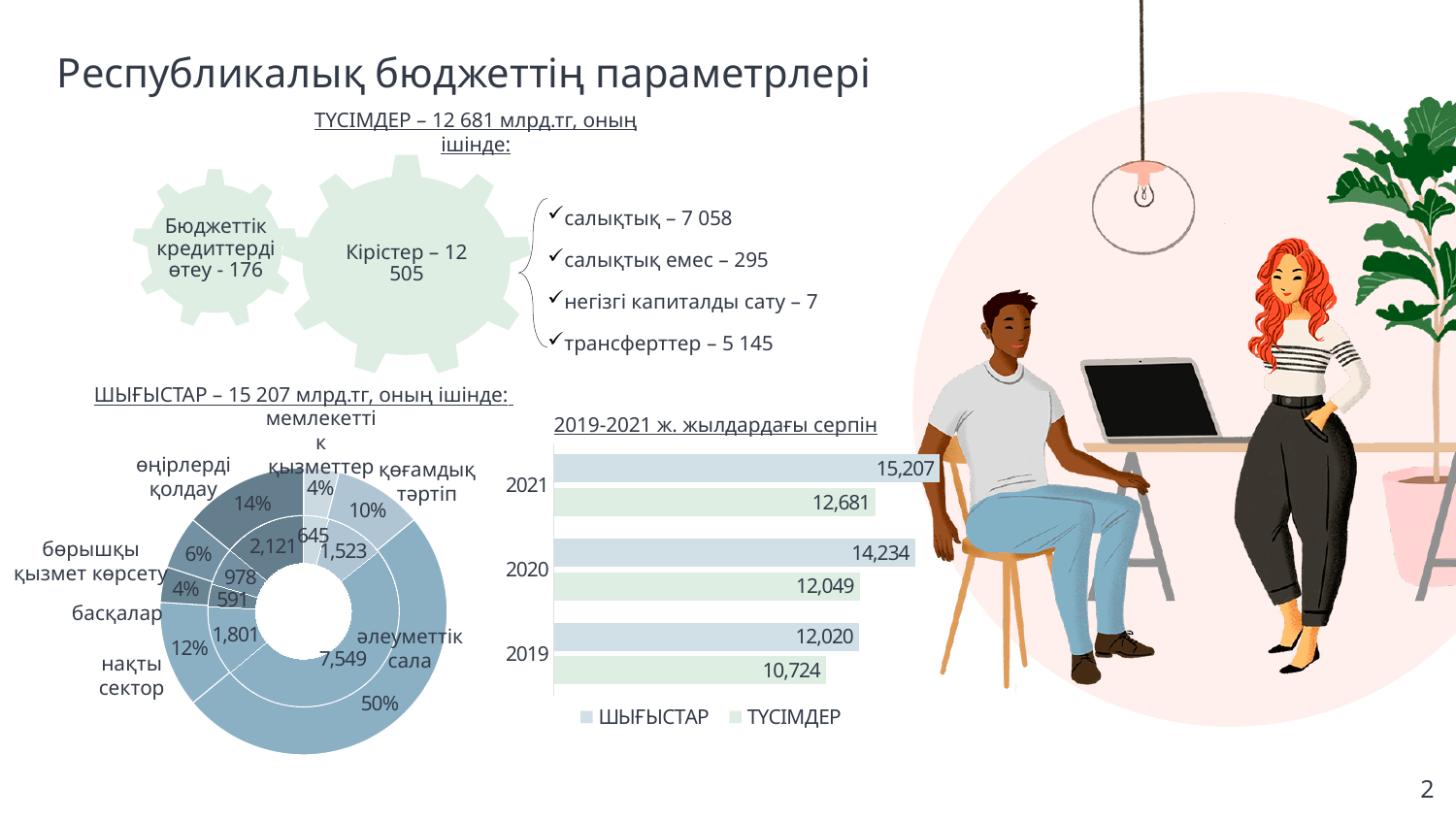
In the doughnut chart under "ШЫҒЫСТАР – 15 207 млрд.тг", which is larger: нақты сектор or қоғамдық тәртіп? нақты сектор In the doughnut chart under "ШЫҒЫСТАР – 15 207 млрд.тг", what share does өңірлерді қолдау have? 14% In the doughnut chart under "ШЫҒЫСТАР – 15 207 млрд.тг", what is the value for әлеуметтік сала? 7,549 In the bar chart titled "2019-2021 ж. жылдардағы серпін", how many series does the legend list? 2 In the bar chart titled "2019-2021 ж. жылдардағы серпін", does the ШЫҒЫСТАР value rise or fall from 2019 to 2021? rise In the doughnut chart under "ШЫҒЫСТАР – 15 207 млрд.тг", which category has the largest share? әлеуметтік сала In the bar chart titled "2019-2021 ж. жылдардағы серпін", what is the value of ШЫҒЫСТАР for 2021? 15,207 In the bar chart titled "2019-2021 ж. жылдардағы серпін", what is the value of ТҮСІМДЕР for 2019? 10,724 What kind of chart is the "2019-2021 ж. жылдардағы серпін" chart? bar chart In the doughnut chart under "ШЫҒЫСТАР – 15 207 млрд.тг", how many categories are shown? 7 In the bar chart titled "2019-2021 ж. жылдардағы серпін", what is the difference between ШЫҒЫСТАР and ТҮСІМДЕР in 2020? 2,185 In the bar chart titled "2019-2021 ж. жылдардағы серпін", what is the value of ТҮСІМДЕР for 2020? 12,049